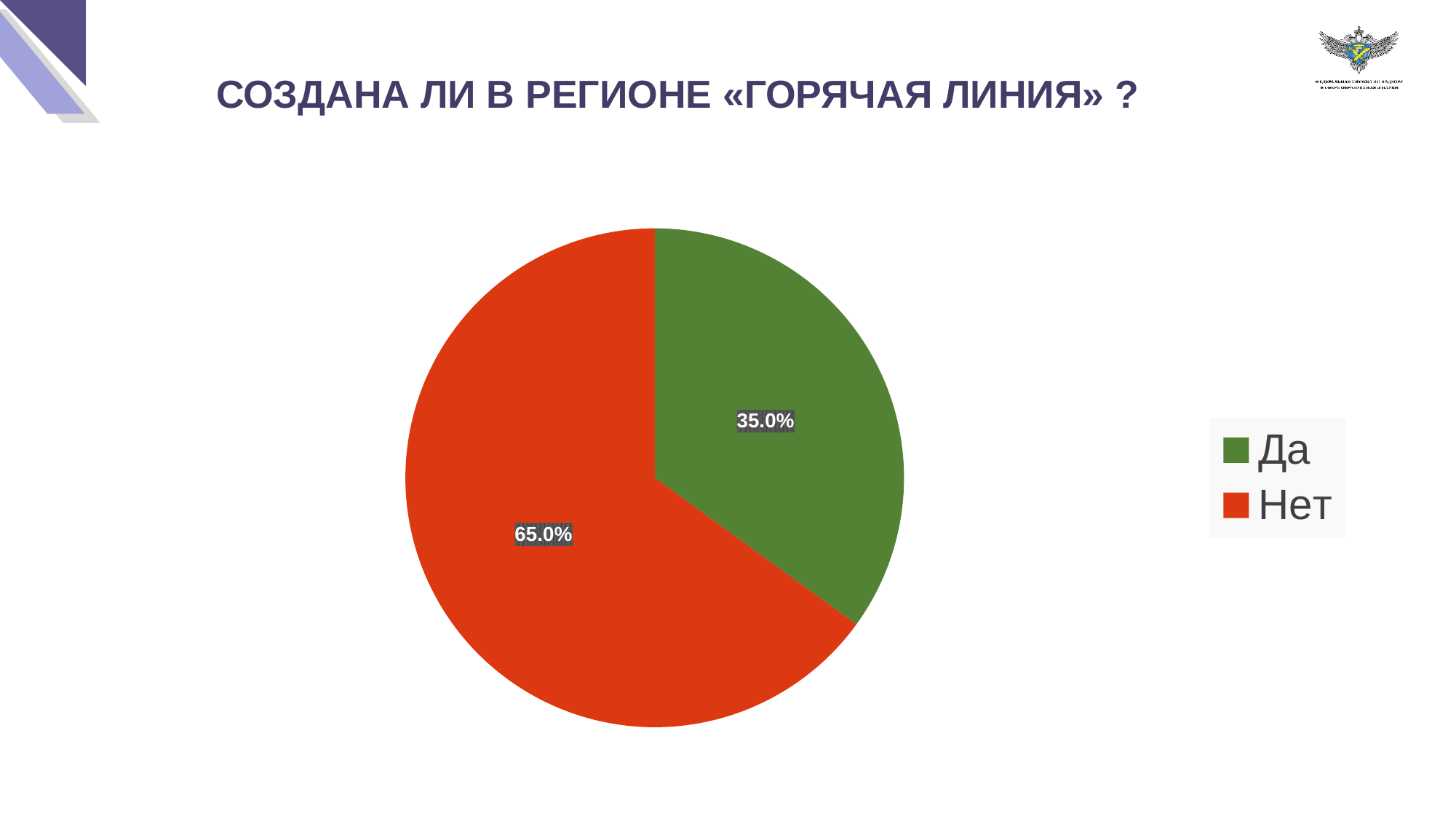
What share of the pie does the "Нет" slice represent? 65.0% Which is larger, the "Да" slice or the "Нет" slice? Нет What is the title of the slide above the chart? СОЗДАНА ЛИ В РЕГИОНЕ «ГОРЯЧАЯ ЛИНИЯ» ? How many slices does the pie chart have? 2 What kind of chart is shown on the slide? Pie chart What colour is the "Нет" slice? Red Which slice is the largest in the pie chart? Нет How many entries does the legend list? 2 What is the difference in percentage points between the "Нет" and "Да" slices? 30.0% Which slice is the smallest in the pie chart? Да What share of the pie does the "Да" slice represent? 35.0%